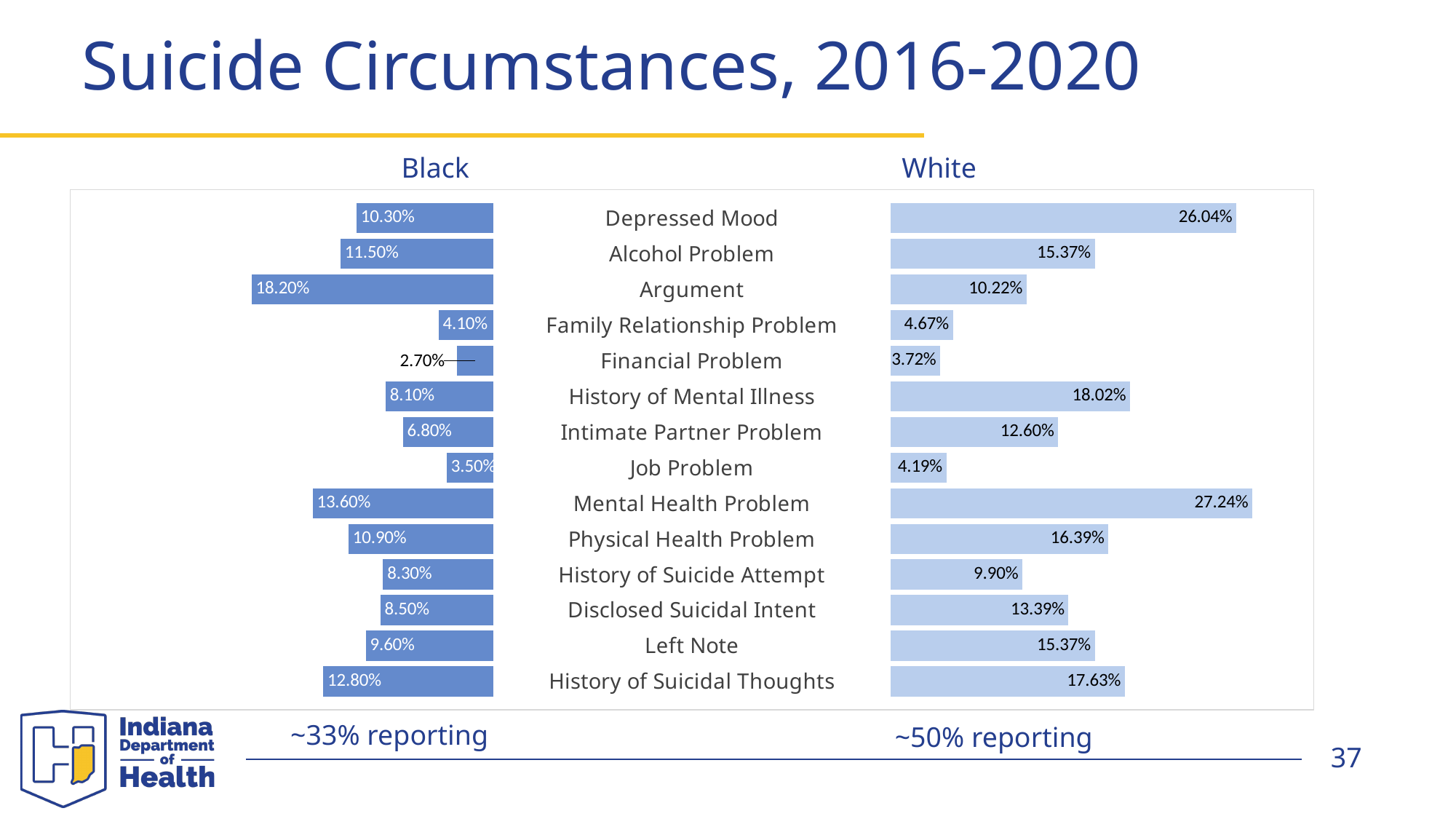
What is the value for Left Note in the White series? 15.37% Which circumstance has the highest value in the Black series? Argument What is the value for Financial Problem in the Black series? 2.70% What is the difference between the White and Black values for Depressed Mood? 15.74 percentage points What is the value for Mental Health Problem in the White series? 27.24% What is the value for Depressed Mood in the Black series? 10.30% Which circumstance has the lowest value in the White series? Financial Problem How many series does the chart show? 2 Which circumstance has the highest value in the White series? Mental Health Problem For Argument, which series has the larger value, Black or White? Black What kind of chart is shown on the slide? Bar chart How many circumstance categories are shown in the chart? 14